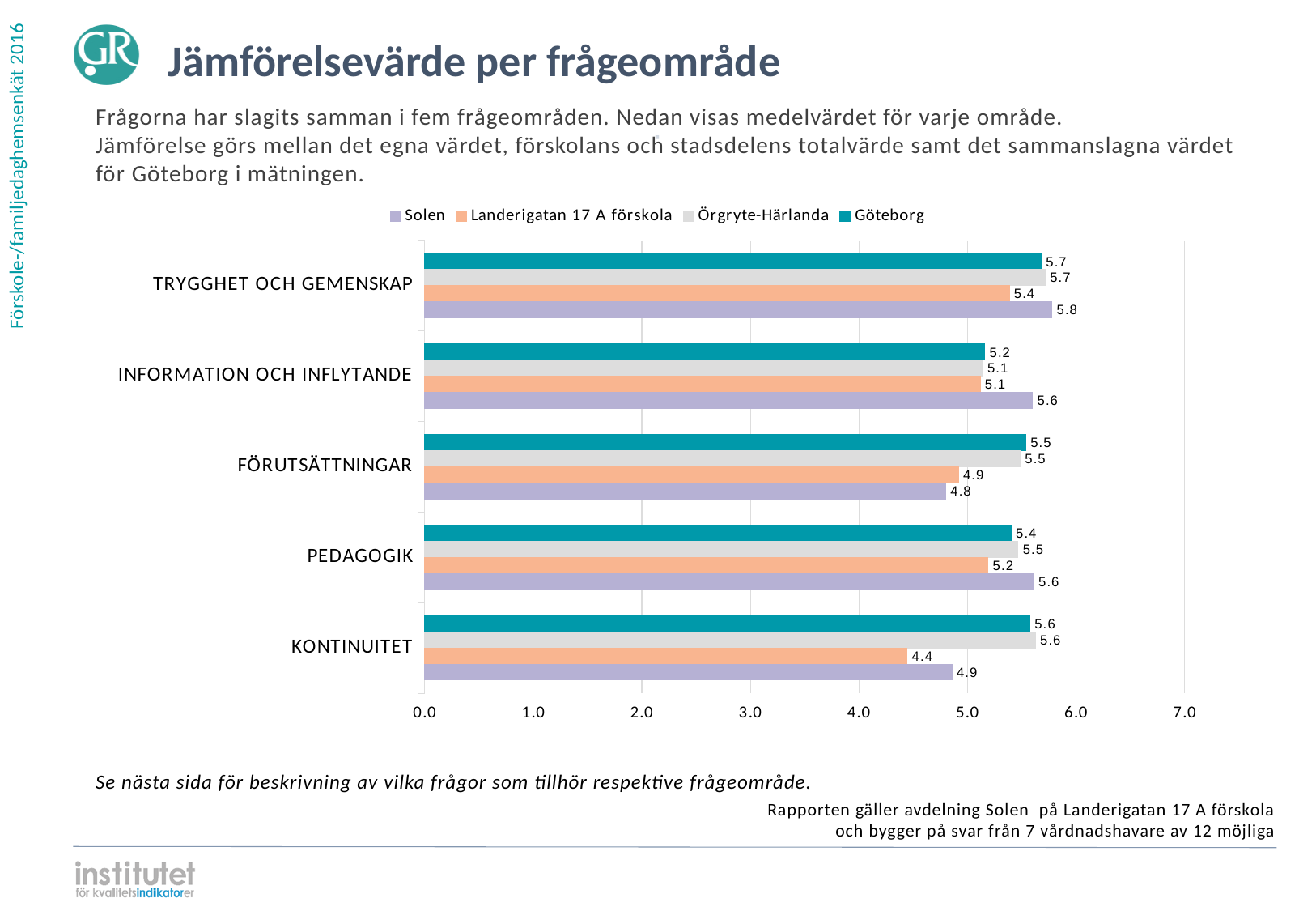
Is the Solen value for INFORMATION OCH INFLYTANDE greater or less than 5.0? greater How many categories (frågeområden) are shown on the chart? 5 What is the value for Göteborg in the PEDAGOGIK category? 5.4 In which category does the Solen series have its lowest value? FÖRUTSÄTTNINGAR What is the difference between the Solen value and the Landerigatan 17 A förskola value in the KONTINUITET category? 0.5 What is the value for Landerigatan 17 A förskola in the KONTINUITET category? 4.4 In which category does the Solen series have its highest value? TRYGGHET OCH GEMENSKAP What kind of chart is shown on the slide? Bar chart What is the value for Solen in the TRYGGHET OCH GEMENSKAP category? 5.8 What is the value for Örgryte-Härlanda in the INFORMATION OCH INFLYTANDE category? 5.1 In the FÖRUTSÄTTNINGAR category, which is larger: the Göteborg value or the Solen value? Göteborg How many series does the legend list? 4